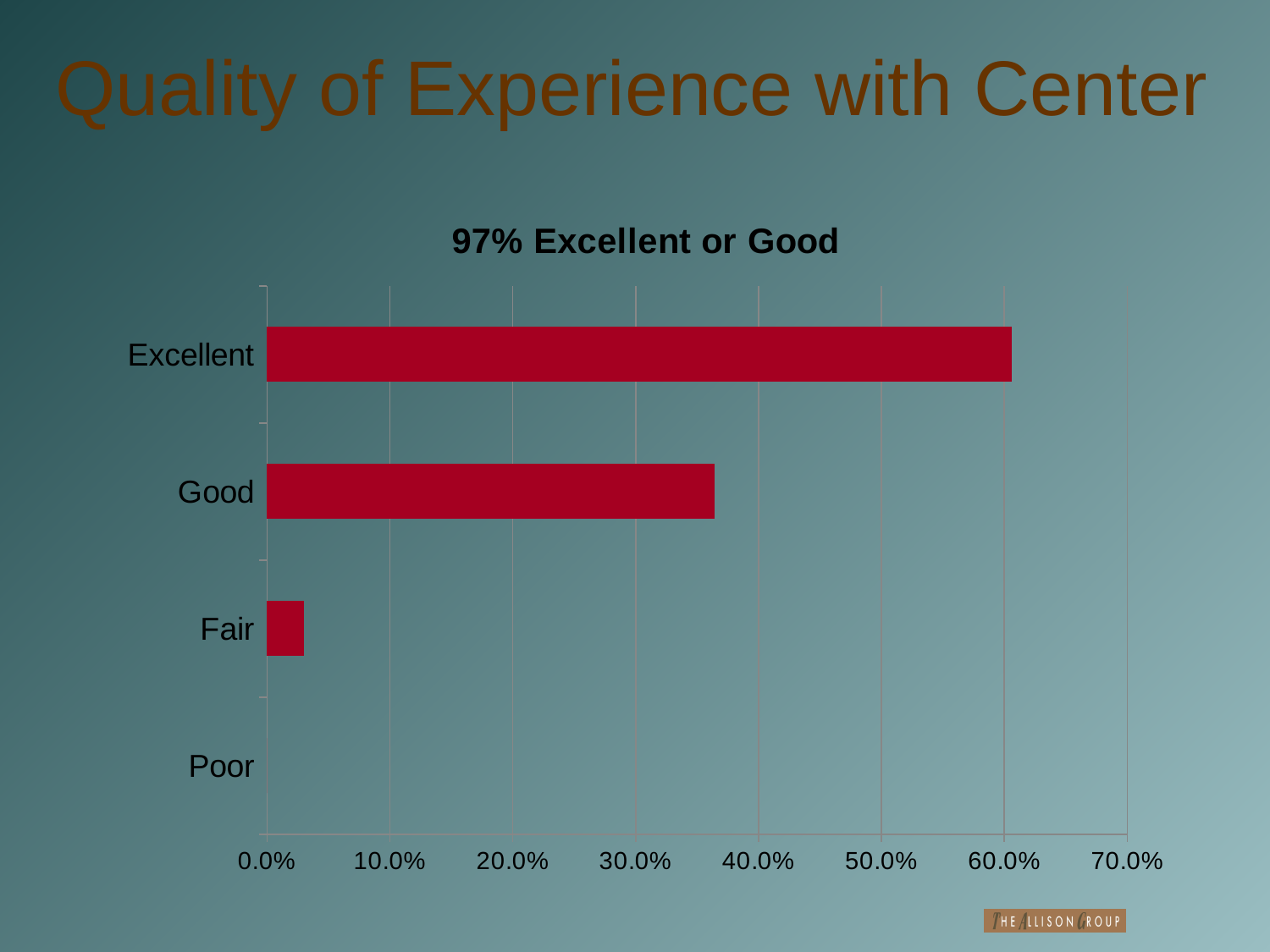
Do the values rise or fall going down the categories from Excellent to Poor? fall Which category has the lowest value? Poor Which is larger, the value for Good or the value for Fair? Good Which category has the highest value? Excellent Is the value for Good greater or less than 40.0%? less Is the value for Excellent greater or less than 50.0%? greater How many categories are shown on the chart? 4 Is the value for Fair greater or less than 10.0%? less What is the title shown above the chart? 97% Excellent or Good What kind of chart is shown on the slide? bar chart Which is larger, the value for Excellent or the value for Good? Excellent